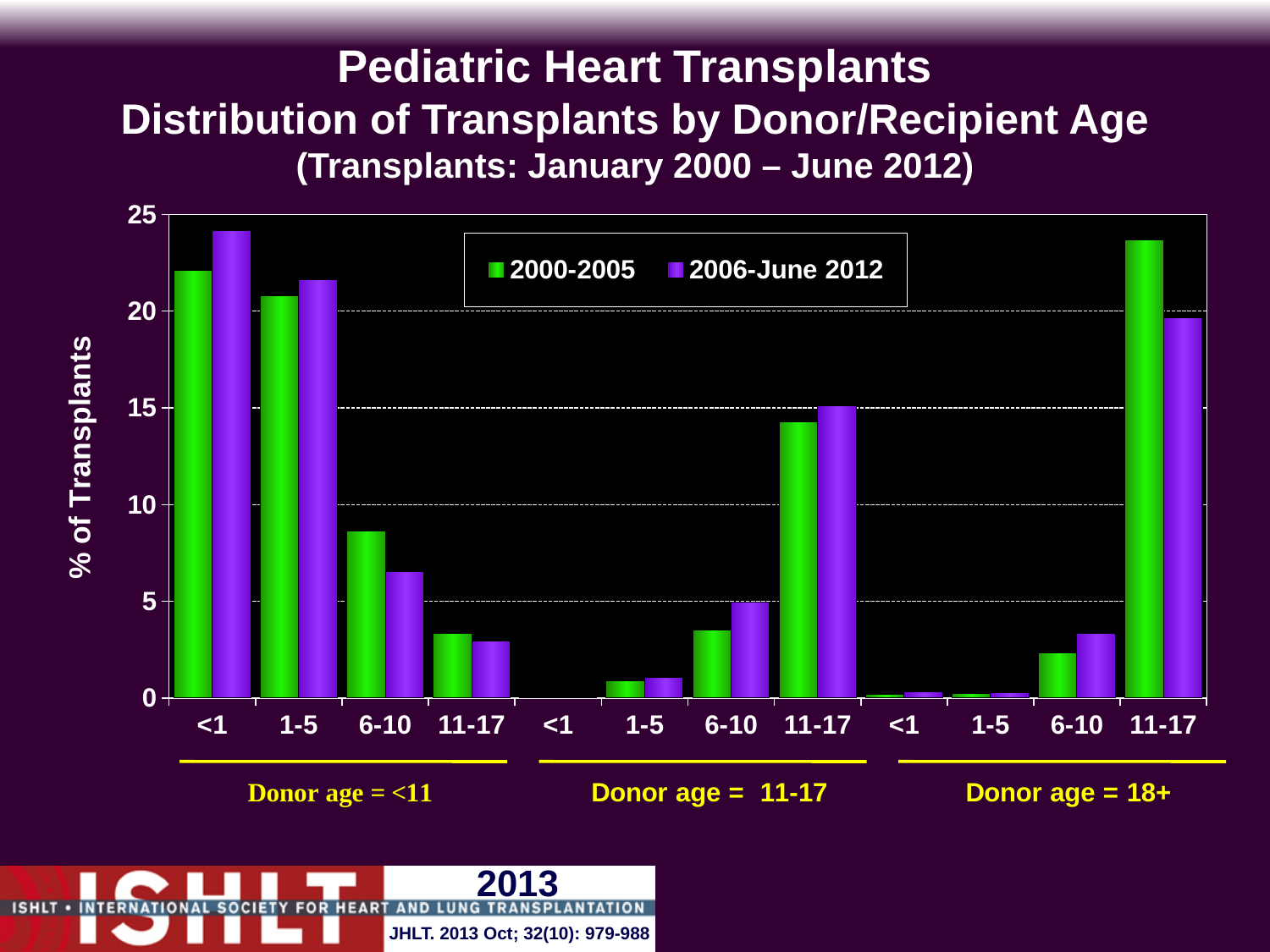
What kind of chart is shown on the slide? bar chart For donor age <11 and recipient age 6-10, is the 2000-2005 value greater or less than 5? greater For donor age 11-17 and recipient age 6-10, which series has the larger value, 2000-2005 or 2006-June 2012? 2006-June 2012 What are the two series named in the legend? 2000-2005 and 2006-June 2012 Which donor/recipient age combination has the highest 2006-June 2012 value? Donor age <11, recipient age <1 For donor age <11 and recipient age <1, is the 2006-June 2012 value greater or less than 20? greater What is the label on the vertical axis? % of Transplants For donor age 11-17 and recipient age 11-17, is the 2006-June 2012 value greater or less than 10? greater How many donor age groups are shown along the x axis? 3 For donor age <11 and recipient age 6-10, which series has the larger value, 2000-2005 or 2006-June 2012? 2000-2005 How many series does the legend list? 2